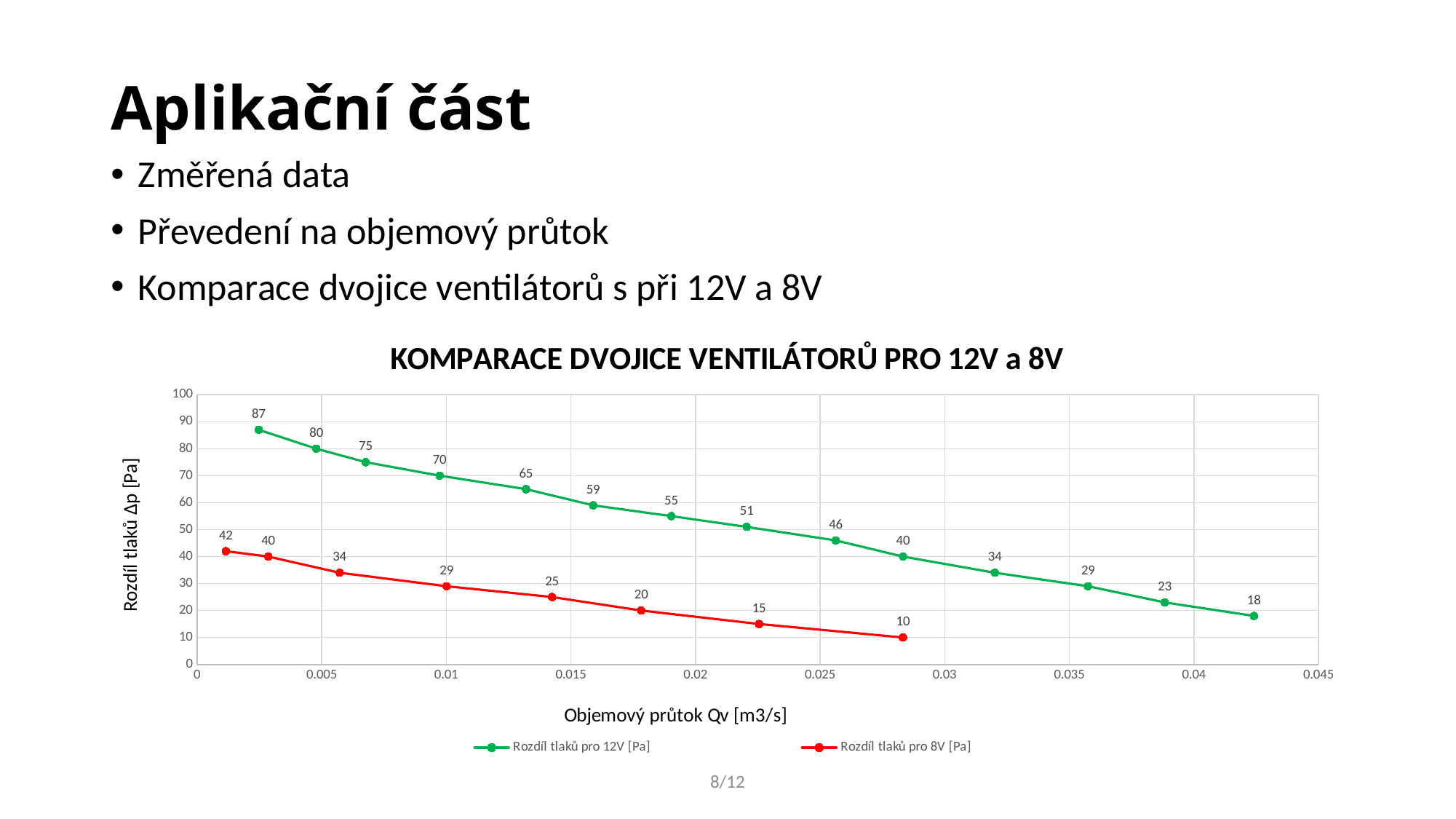
How many data points are plotted for the series 'Rozdíl tlaků pro 8V [Pa]'? 8 What is the lowest value plotted for the series 'Rozdíl tlaků pro 8V [Pa]'? 10 How many series does the legend list? 2 How many data points are plotted for the series 'Rozdíl tlaků pro 12V [Pa]'? 14 What is the difference between the highest value of the 12V series and the highest value of the 8V series? 45 What is the highest value plotted for the series 'Rozdíl tlaků pro 12V [Pa]'? 87 Which series is drawn in red? Rozdíl tlaků pro 8V [Pa] What is the highest value plotted for the series 'Rozdíl tlaků pro 8V [Pa]'? 42 What is the lowest value plotted for the series 'Rozdíl tlaků pro 12V [Pa]'? 18 What type of chart is shown on the slide? line chart What is the title of the chart? KOMPARACE DVOJICE VENTILÁTORŮ PRO 12V a 8V Do the values of the series 'Rozdíl tlaků pro 12V [Pa]' rise or fall as the volume flow Qv increases? fall